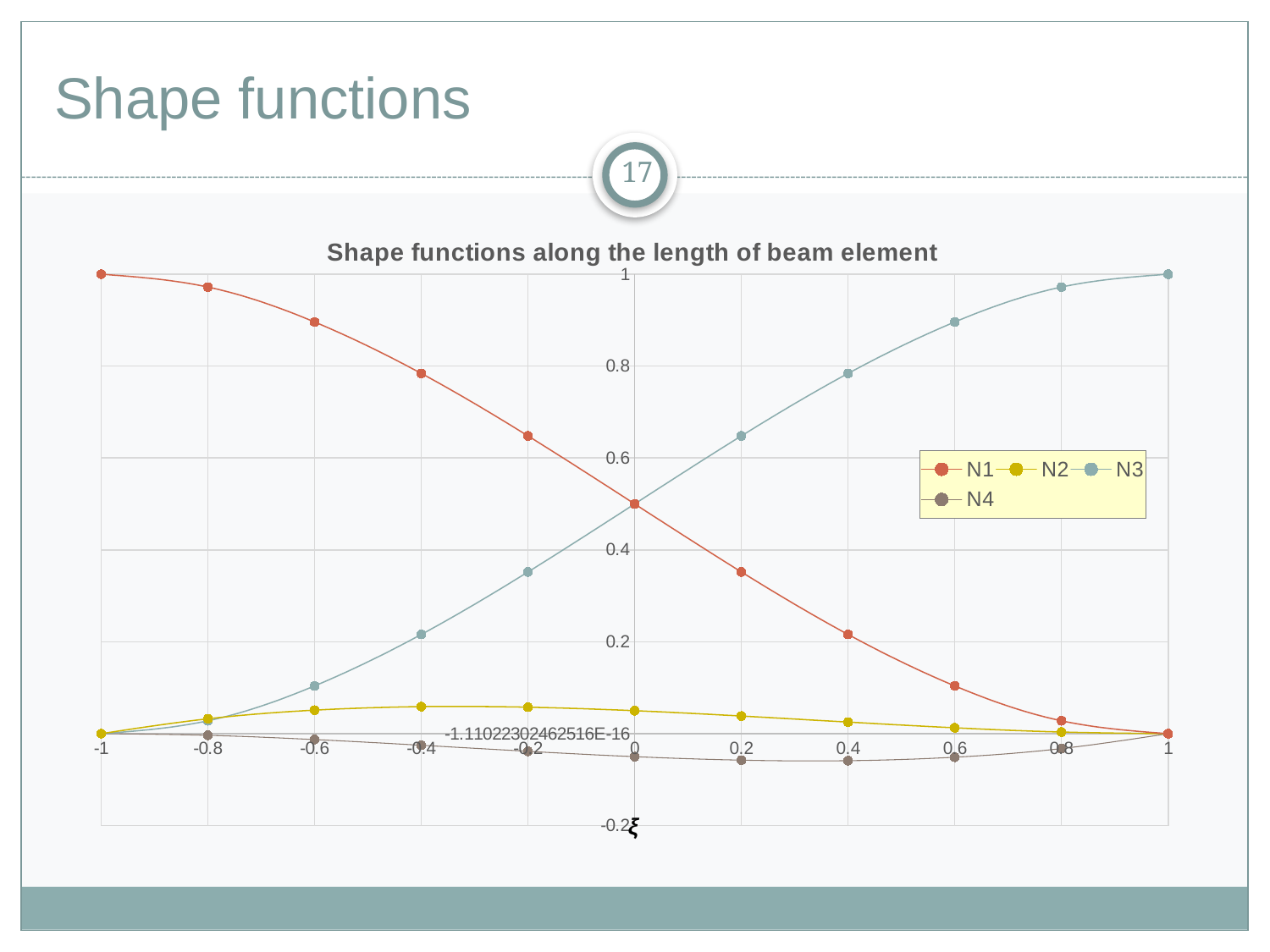
How many series does the legend list? 4 Does N3 rise or fall as ξ increases from -1 to 1? rise At ξ = -0.6, which is larger, N1 or N3? N1 Does N1 rise or fall as ξ increases from -1 to 1? fall Is the value of N1 at ξ = -0.4 greater or less than 0.6? greater What is the value of N1 at ξ = -1? 1 Is the value of N1 at ξ = 0.6 greater or less than 0.2? less What kind of chart is shown on the slide? line chart How many data points are plotted for each series along the x axis? 11 What is the value of N3 at ξ = 1? 1 Which series has the highest value at ξ = 1? N3 What is the title of the chart? Shape functions along the length of beam element